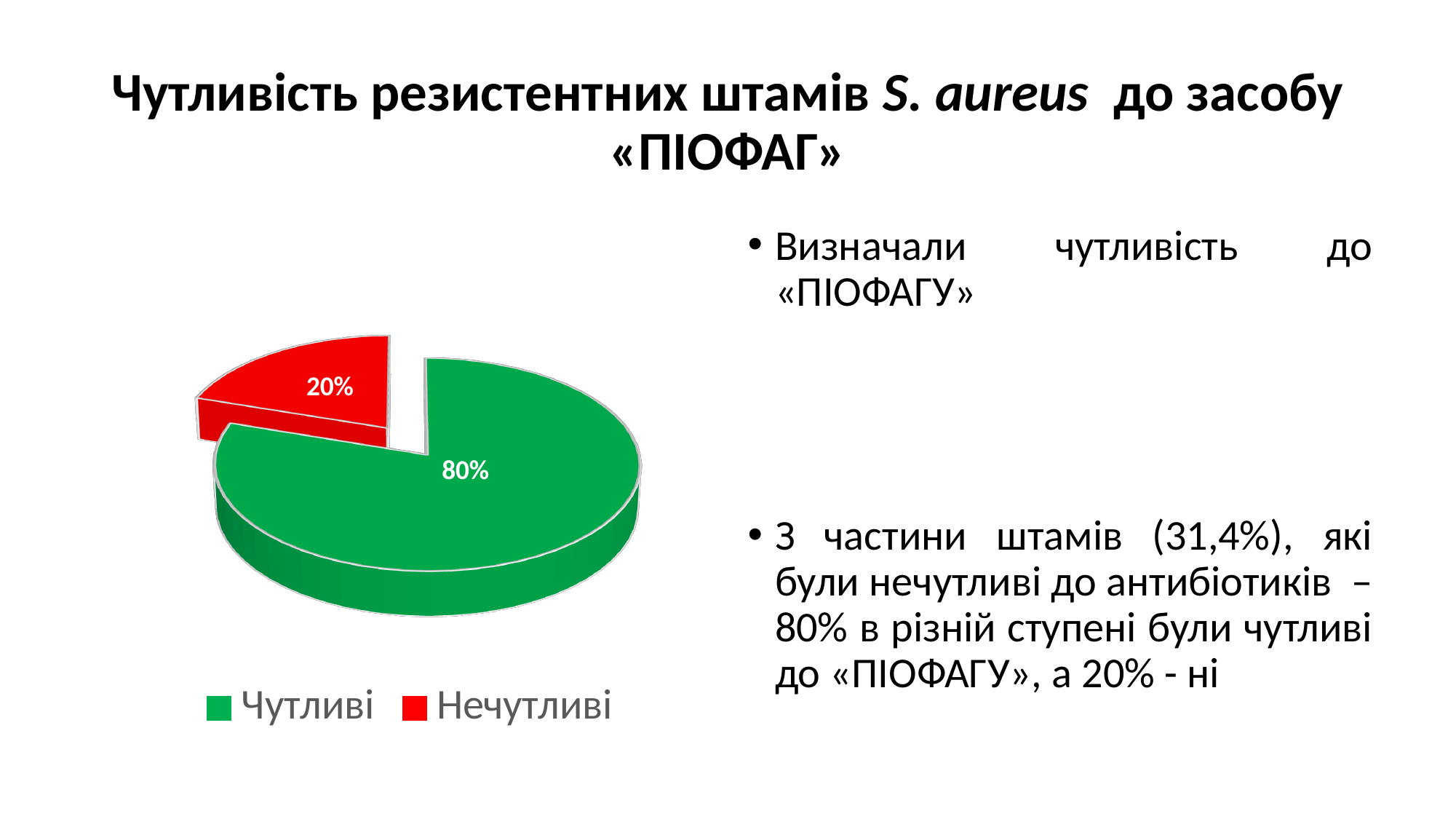
What share of the pie does the Нечутливі slice represent? 20% What kind of chart is shown on the slide? pie chart What colour is the Чутливі slice? green Which slice of the pie is the largest? Чутливі Which slice of the pie is the smallest? Нечутливі What share of the pie does the Чутливі slice represent? 80% How many slices does the pie chart have? 2 How many entries does the legend list? 2 What colour is the Нечутливі slice? red Which is larger, the Чутливі slice or the Нечутливі slice? Чутливі What is the difference in percentage points between the Чутливі and Нечутливі slices? 60